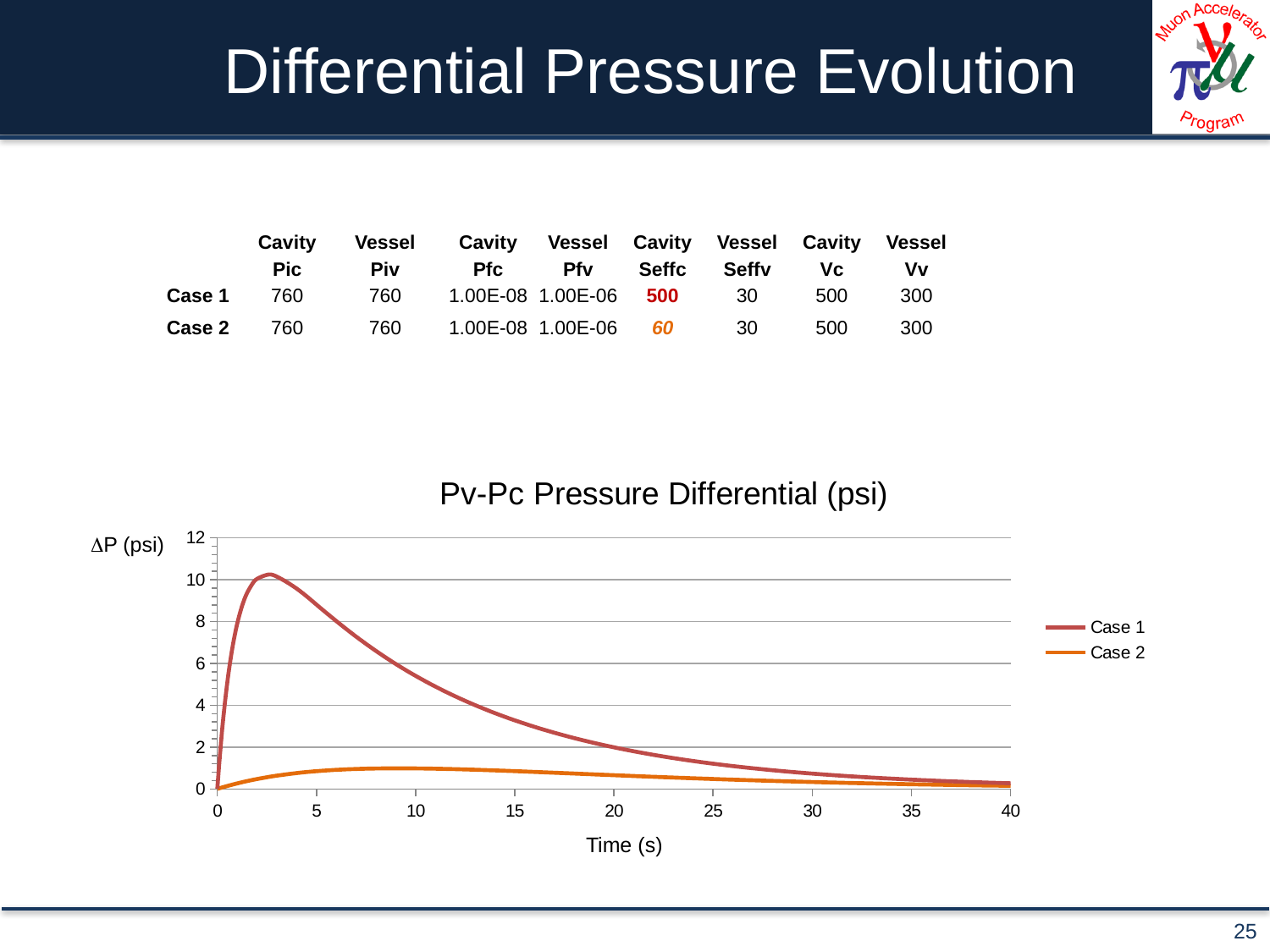
Which series reaches the higher peak value in the chart? Case 1 Is the value for Case 2 at time 10 s greater or less than 2? less What is the label of the x axis of the chart? Time (s) Is the value for Case 1 at time 5 s greater or less than 8? greater What is the title of the chart? Pv-Pc Pressure Differential (psi) After its peak, does the Case 1 curve rise or fall as time increases? fall What kind of chart is shown on the slide? line chart Is the peak value of Case 2 greater or less than 2? less Which series has the lower peak value in the chart? Case 2 At time 5 s, which series has the larger value, Case 1 or Case 2? Case 1 How many series does the legend of the chart list? 2